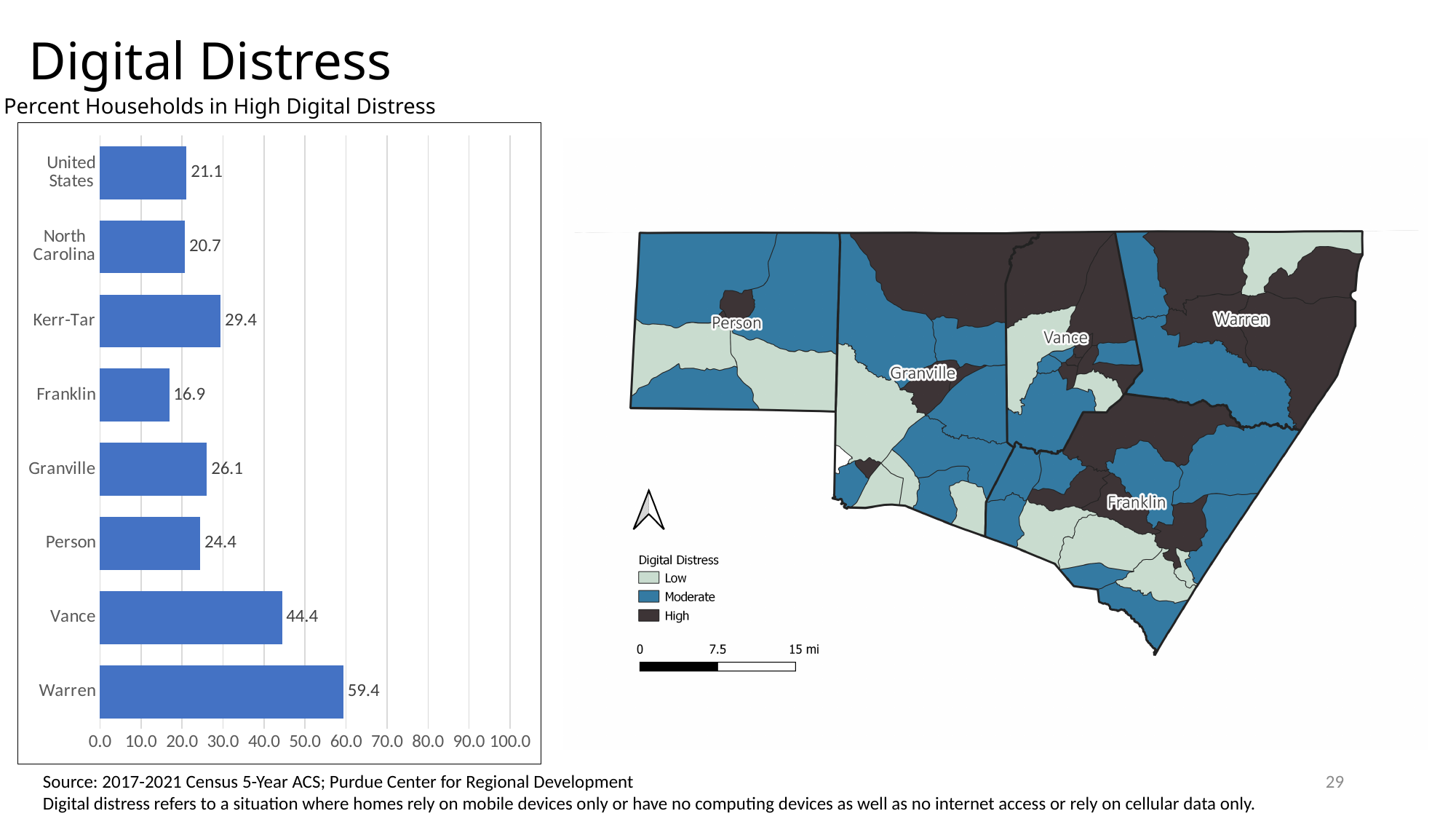
Which is larger in the bar chart, the value for Vance or the value for Kerr-Tar? Vance What is the difference between the values for Granville and Person in the bar chart? 1.7 What is the title of the bar chart? Percent Households in High Digital Distress What is the difference between the values for Warren and Vance in the bar chart? 15.0 How many categories are shown in the bar chart? 8 What is the value for Warren in the bar chart? 59.4 Which category has the highest value in the bar chart? Warren What is the value for Franklin in the bar chart? 16.9 What kind of chart is shown on the left of the slide? Bar chart What is the value for North Carolina in the bar chart? 20.7 What is the value for Kerr-Tar in the bar chart? 29.4 Which category has the lowest value in the bar chart? Franklin